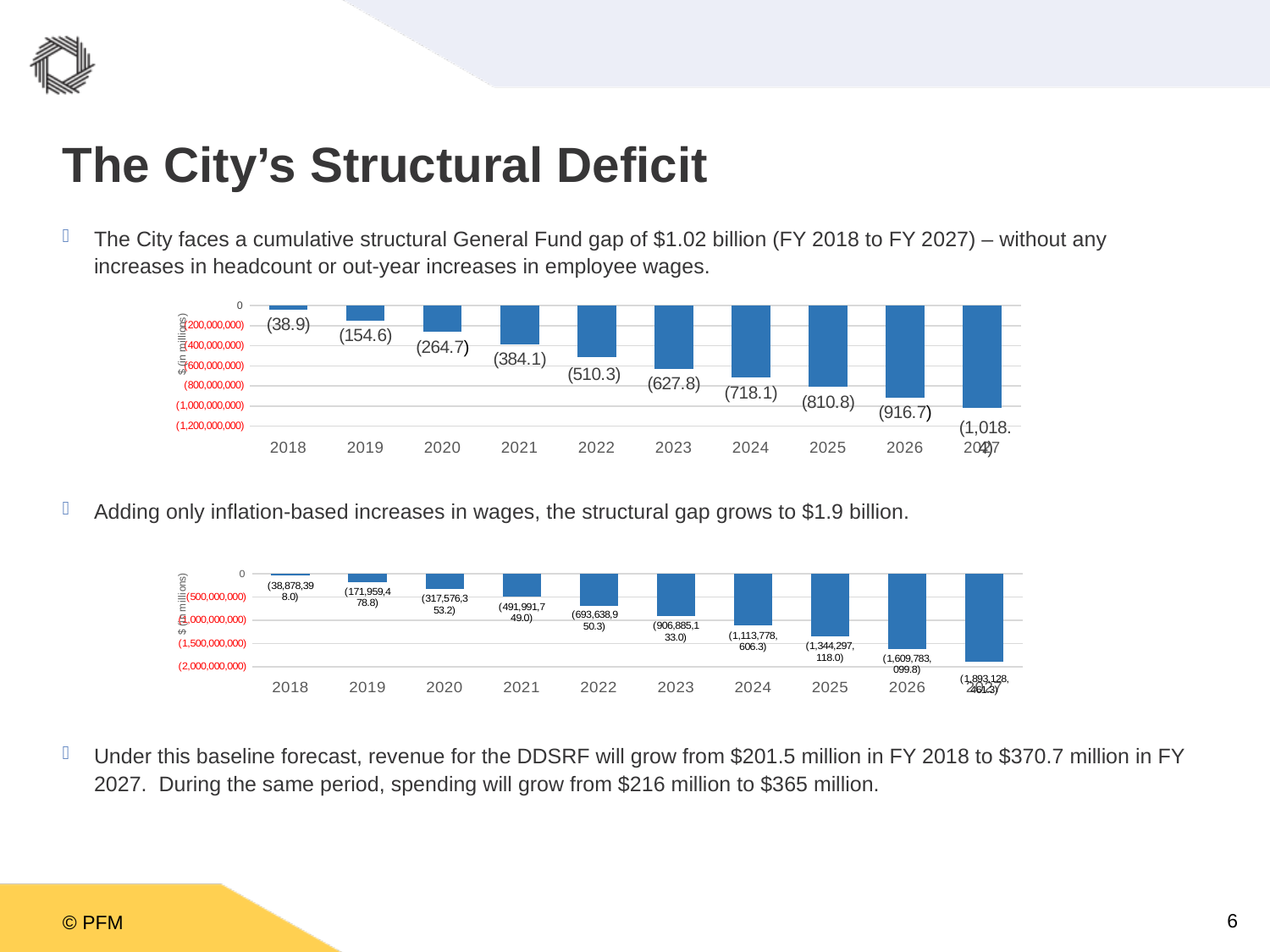
In the bottom chart, what is the value for 2018? (38,878,398.0) What kind of chart is the top chart? bar chart In the top chart, what is the value for 2025? (810.8) In the top chart, what is the value for 2018? (38.9) In the top chart, how many years are shown on the x axis? 10 In the top chart, which year has the smallest deficit (bar closest to zero)? 2018 In the top chart, which year has the largest deficit (longest bar)? 2027 In the bottom chart, which bar is longer, 2023 or 2025? 2025 In the top chart, what is the value for 2022? (510.3) In the bottom chart, what is the value for 2024? (1,113,778,606.3) In the bottom chart, is the bar for 2026 below (more negative than) (1,500,000,000)? yes In the top chart, do the deficits grow or shrink from 2018 to 2027? grow